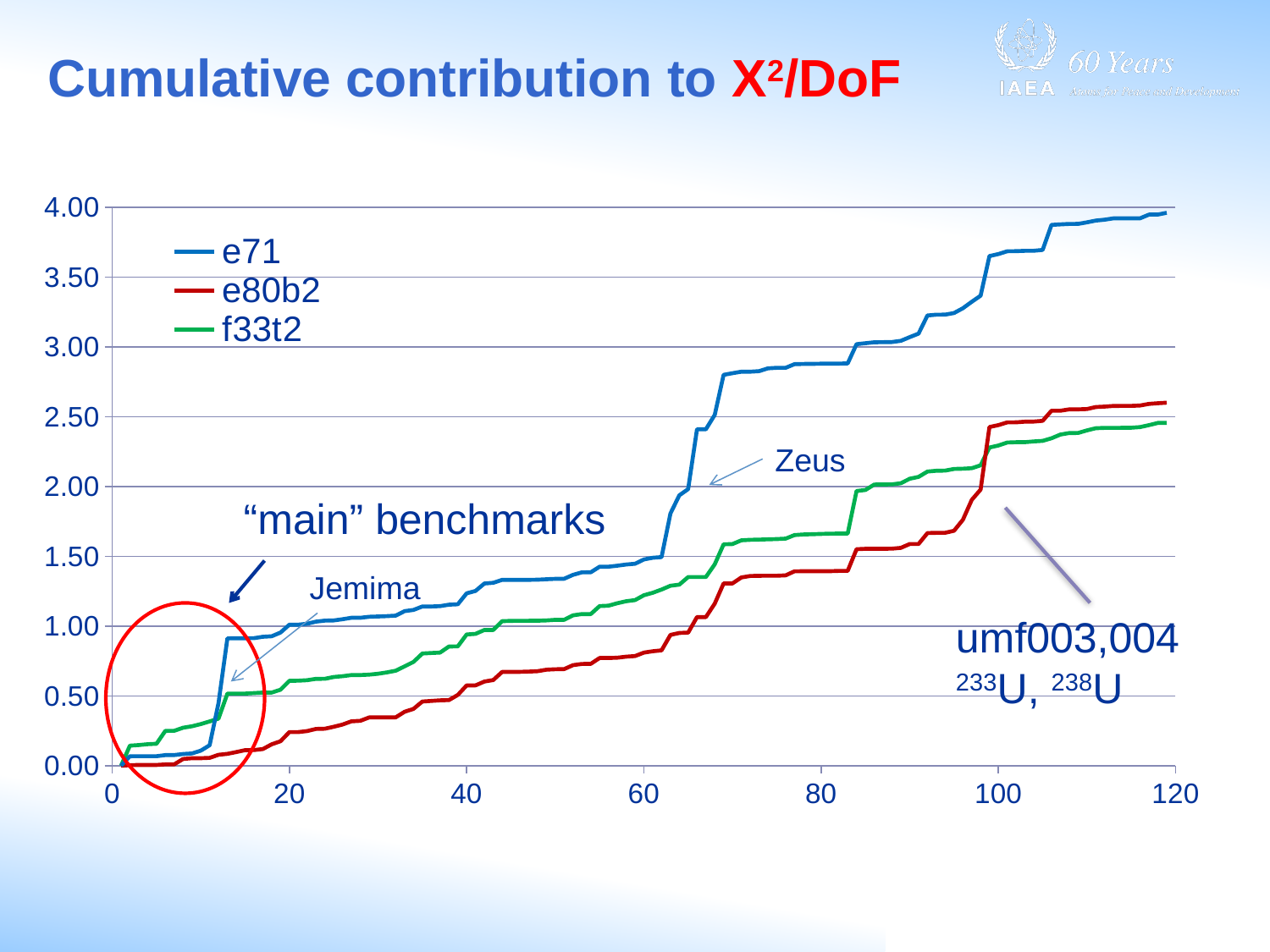
Do the values of the e71 series rise or fall as the x axis increases? rise What kind of chart is shown on the slide? line chart Which series reaches the highest value at the right end of the x axis (120)? e71 Is the value of e71 at x = 100 greater or less than 3.00? greater At x = 60, which series has the larger value, e71 or e80b2? e71 Is the value of e80b2 at x = 60 greater or less than 1.00? less Is the value of f33t2 at x = 80 greater or less than 1.50? greater Which series has the lowest value at x = 40? e80b2 What are the series names listed in the legend? e71, e80b2, f33t2 What is the title of the chart? Cumulative contribution to X²/DoF How many series does the legend list? 3